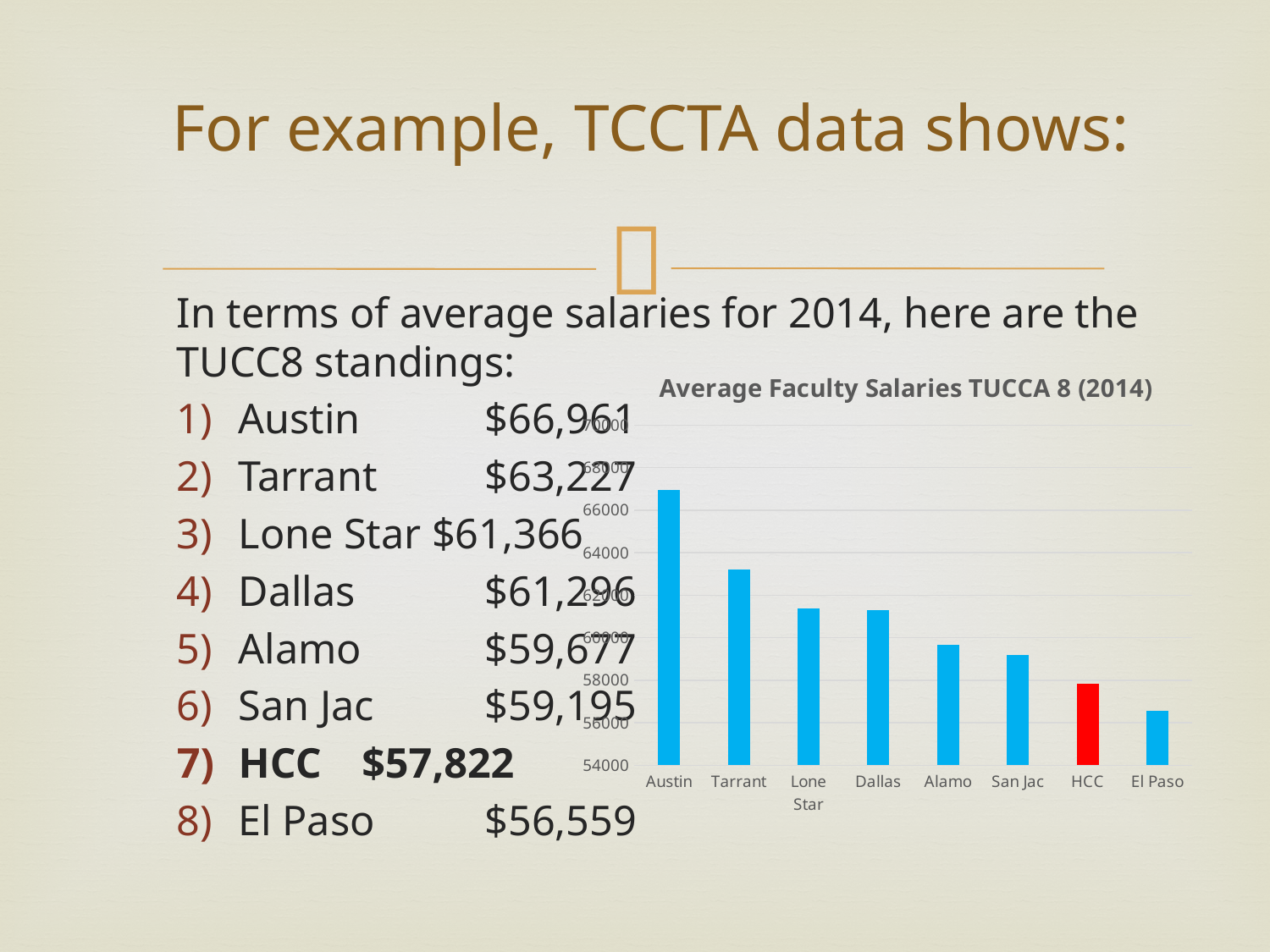
Is the value for Dallas greater or less than 60000? greater What is the average faculty salary for HCC? $57,822 What is the average faculty salary for Austin? $66,961 What is the title of the chart? Average Faculty Salaries TUCCA 8 (2014) Is the value for San Jac greater or less than 60000? less Which college has the highest average faculty salary in the chart? Austin Which college has the lowest average faculty salary in the chart? El Paso How many colleges are shown on the x axis of the chart? 8 What type of chart is shown on the slide? bar chart Do the bar values rise or fall from left to right along the x axis? fall What is the difference between the average salaries of Austin and El Paso? $10,402 Which has a higher average faculty salary, Tarrant or Lone Star? Tarrant